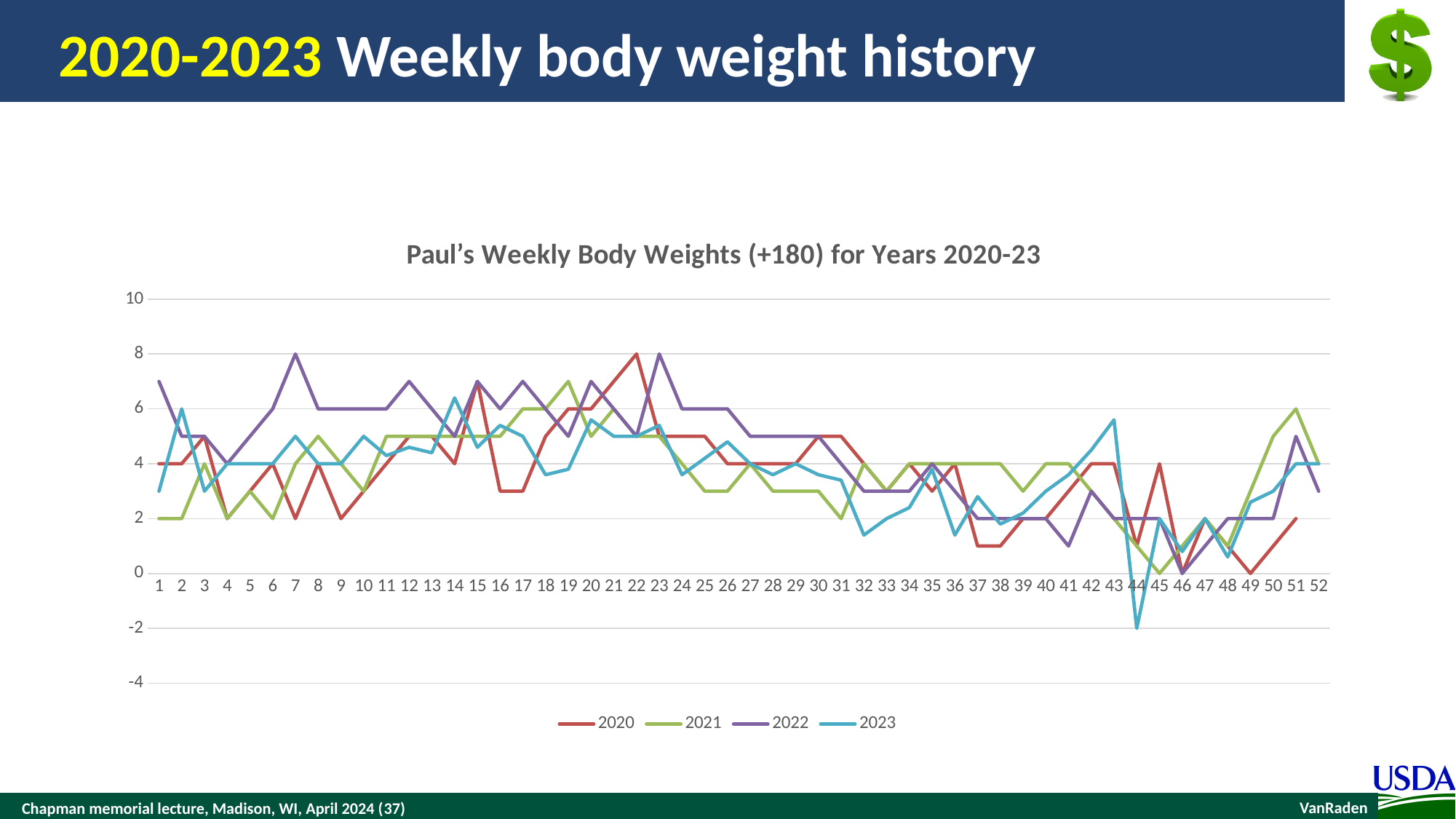
At week 7, which series has the larger value, 2022 or 2020? 2022 At week 1, which series has the highest value? 2022 At week 44, which series has the lowest value? 2023 Is the value for 2022 at week 7 greater or less than 6? greater What is the title of the chart? Paul's Weekly Body Weights (+180) for Years 2020-23 Which years are listed in the legend? 2020, 2021, 2022, 2023 Is the value for 2020 at week 22 greater or less than 6? greater How many weeks are plotted along the x axis? 52 How many series does the legend list? 4 Is the value for 2023 at week 44 greater or less than 0? less What kind of chart is shown on the slide? line chart